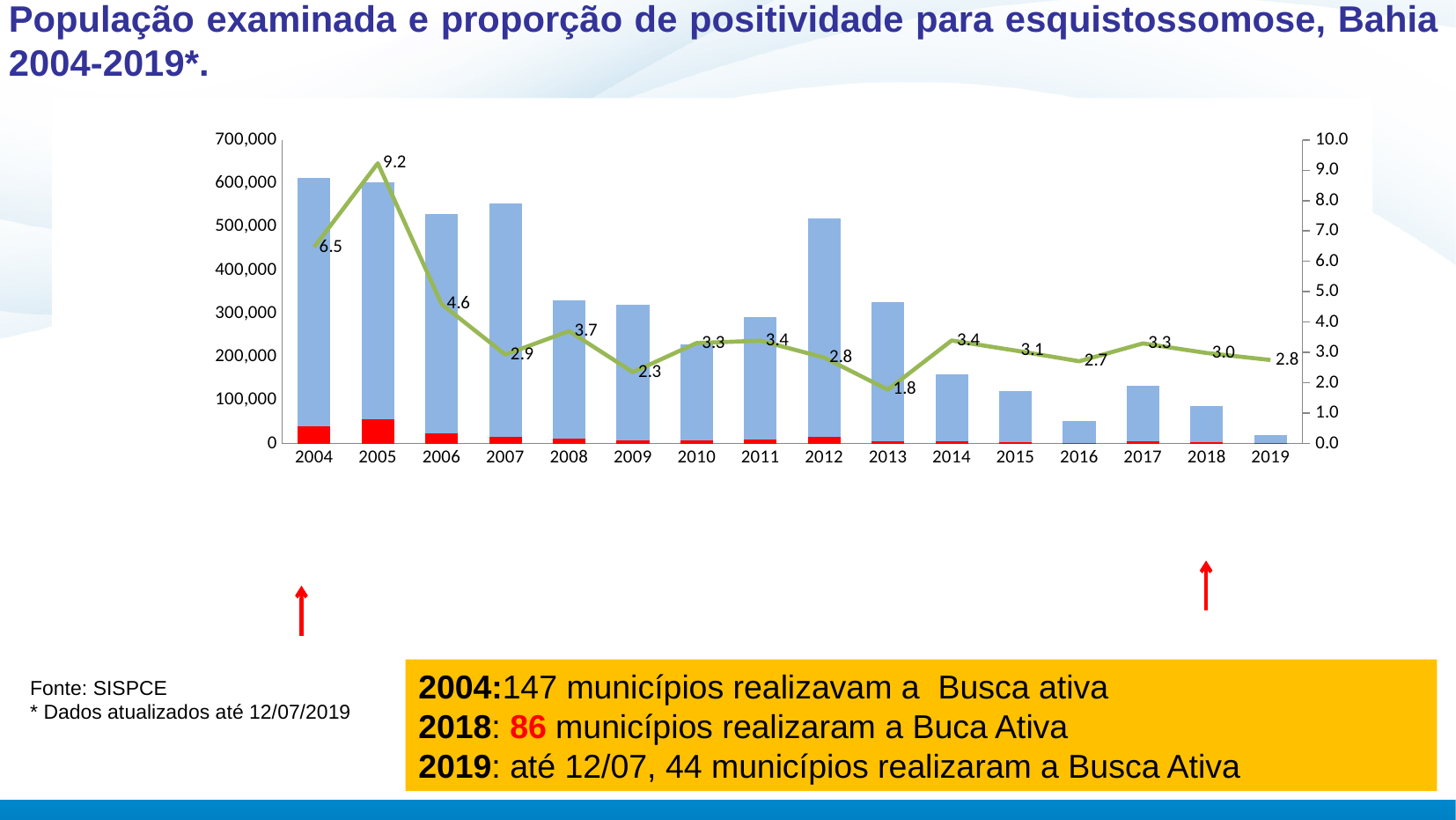
How many years are shown on the x axis? 16 What is the maximum value shown on the right-hand axis? 10.0 Is the total bar height for 2019 greater or less than 100,000? less What is the positivity proportion value shown on the line for 2019? 2.8 What kind of chart is shown on the slide? A bar chart combined with a line chart Does the line value rise or fall from 2005 to 2009? fall What is the difference between the line values for 2005 and 2004? 2.7 In which year does the line reach its lowest value? 2013 Is the total bar height for 2007 greater or less than 500,000? greater In which year does the line reach its highest value? 2005 Which year has the higher line value, 2006 or 2007? 2006 What is the positivity proportion value shown on the line for 2005? 9.2